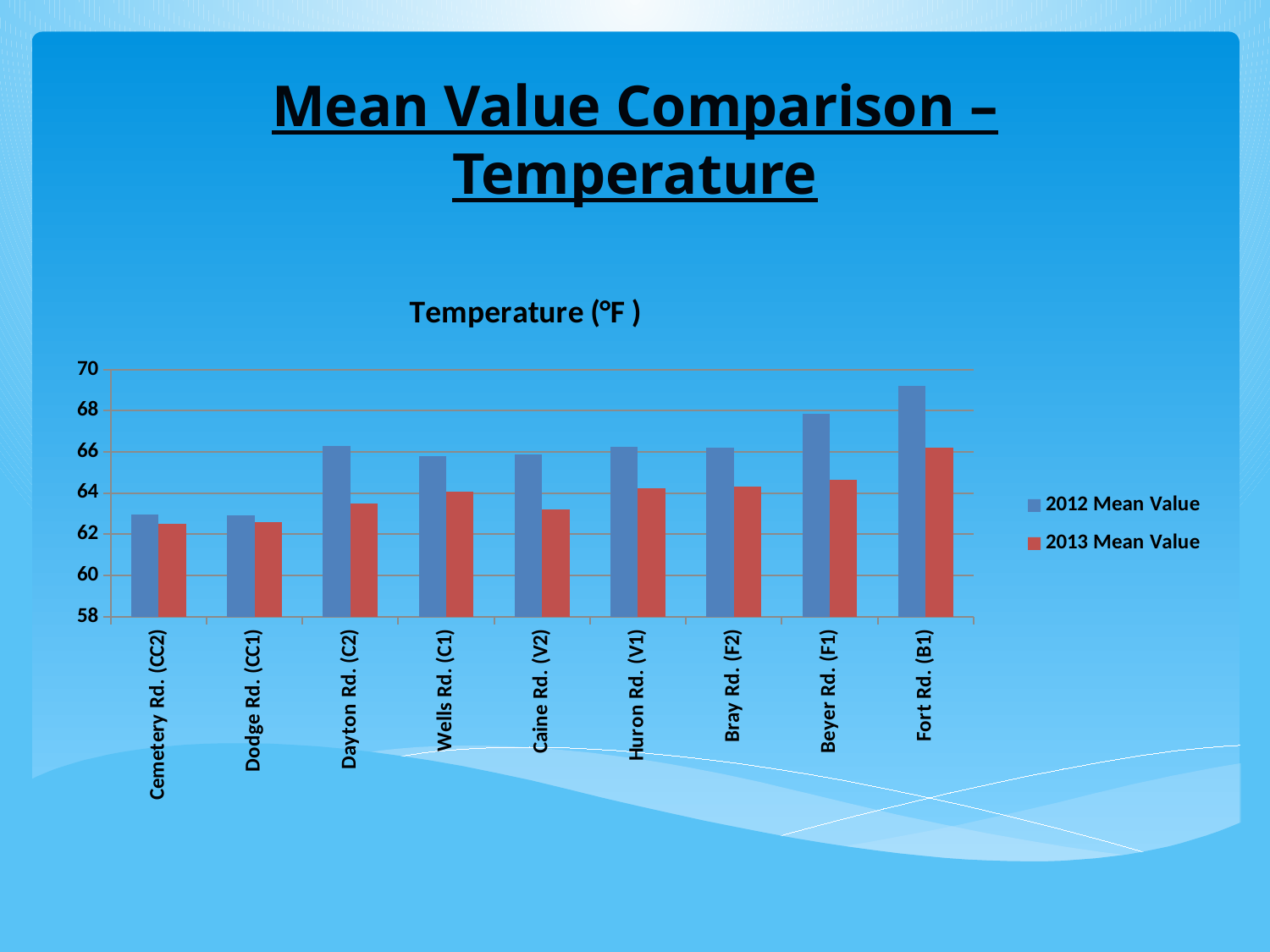
Which site has the highest 2013 Mean Value? Fort Rd. (B1) What kind of chart is shown on the slide? bar chart How many series does the legend list? 2 Is the 2013 Mean Value for Caine Rd. (V2) greater or less than 64? less Which site has the highest 2012 Mean Value? Fort Rd. (B1) What is the title of the chart? Temperature (°F ) Is the 2012 Mean Value for Fort Rd. (B1) greater or less than 68? greater How many road sites are shown along the x axis? 9 For Fort Rd. (B1), which is larger, the 2012 Mean Value or the 2013 Mean Value? 2012 Mean Value Which is larger, the 2012 Mean Value for Dayton Rd. (C2) or for Dodge Rd. (CC1)? Dayton Rd. (C2) Is the 2012 Mean Value for Cemetery Rd. (CC2) greater or less than 64? less